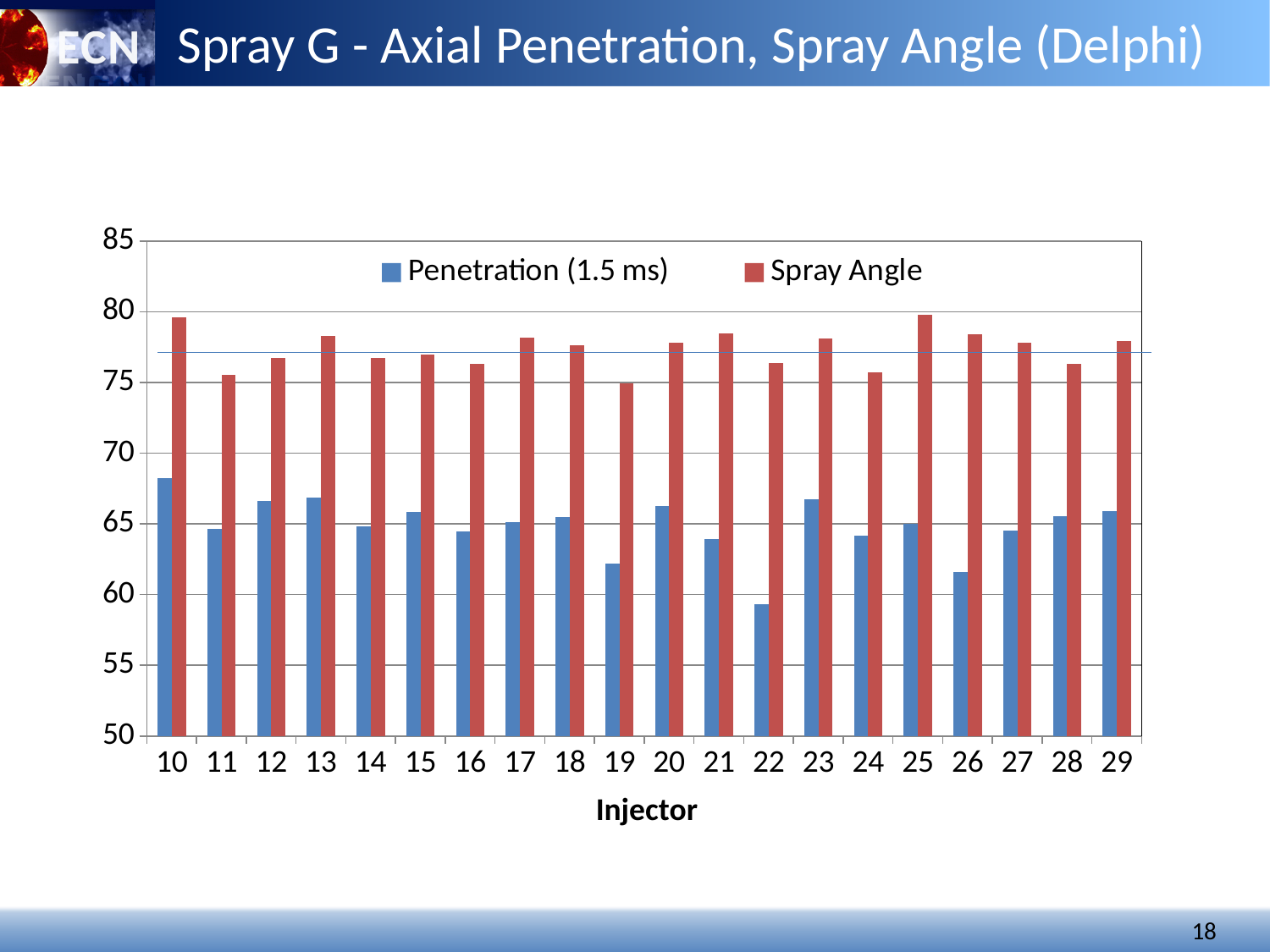
How many series does the legend list? 2 What is the title of the x axis? Injector What are the two series named in the legend? Penetration (1.5 ms) and Spray Angle Which injector has the highest Penetration (1.5 ms) value? 10 Which injector has the lowest Penetration (1.5 ms) value? 22 Is the Penetration (1.5 ms) value for injector 22 greater or less than 60? less How many injectors are shown along the x axis? 20 Is the Penetration (1.5 ms) value for injector 26 greater or less than 60? greater What kind of chart is shown on the slide? Bar chart Which is larger, the Spray Angle for injector 10 or for injector 19? Injector 10 Is the Penetration (1.5 ms) value for injector 10 greater or less than 65? greater